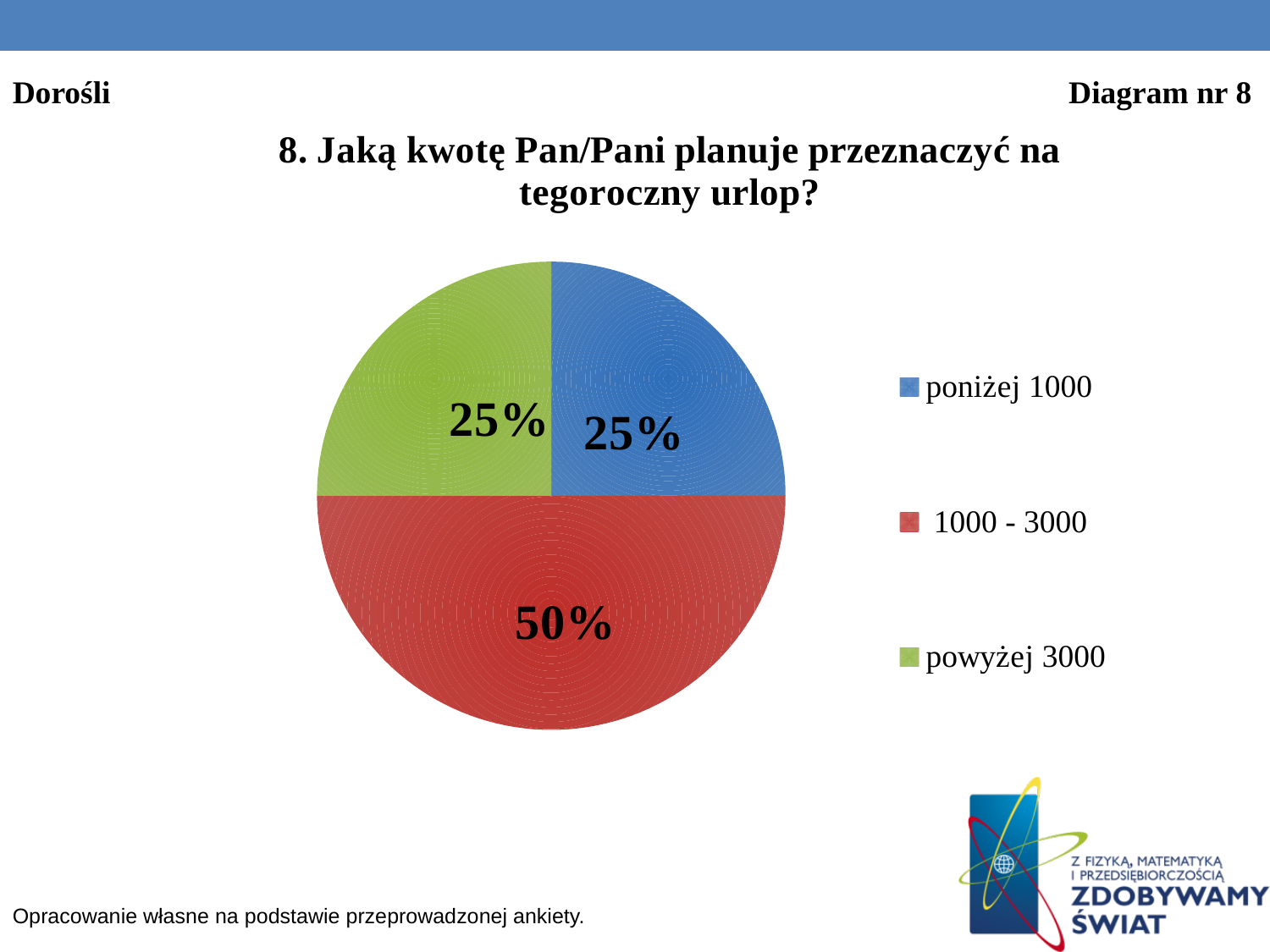
What share of the pie does the "powyżej 3000" slice take? 25% What colour is the "1000 - 3000" slice? red What share of the pie does the "1000 - 3000" slice take? 50% What share of the pie does the "poniżej 1000" slice take? 25% How many entries does the legend list? 3 What is the difference between the share for "1000 - 3000" and the share for "poniżej 1000"? 25% Which is larger: the share for "1000 - 3000" or the share for "powyżej 3000"? 1000 - 3000 Which category has the largest slice of the pie? 1000 - 3000 What kind of chart is shown on the slide? pie chart How many slices does the pie chart have? 3 What is the title of the chart? 8. Jaką kwotę Pan/Pani planuje przeznaczyć na tegoroczny urlop?